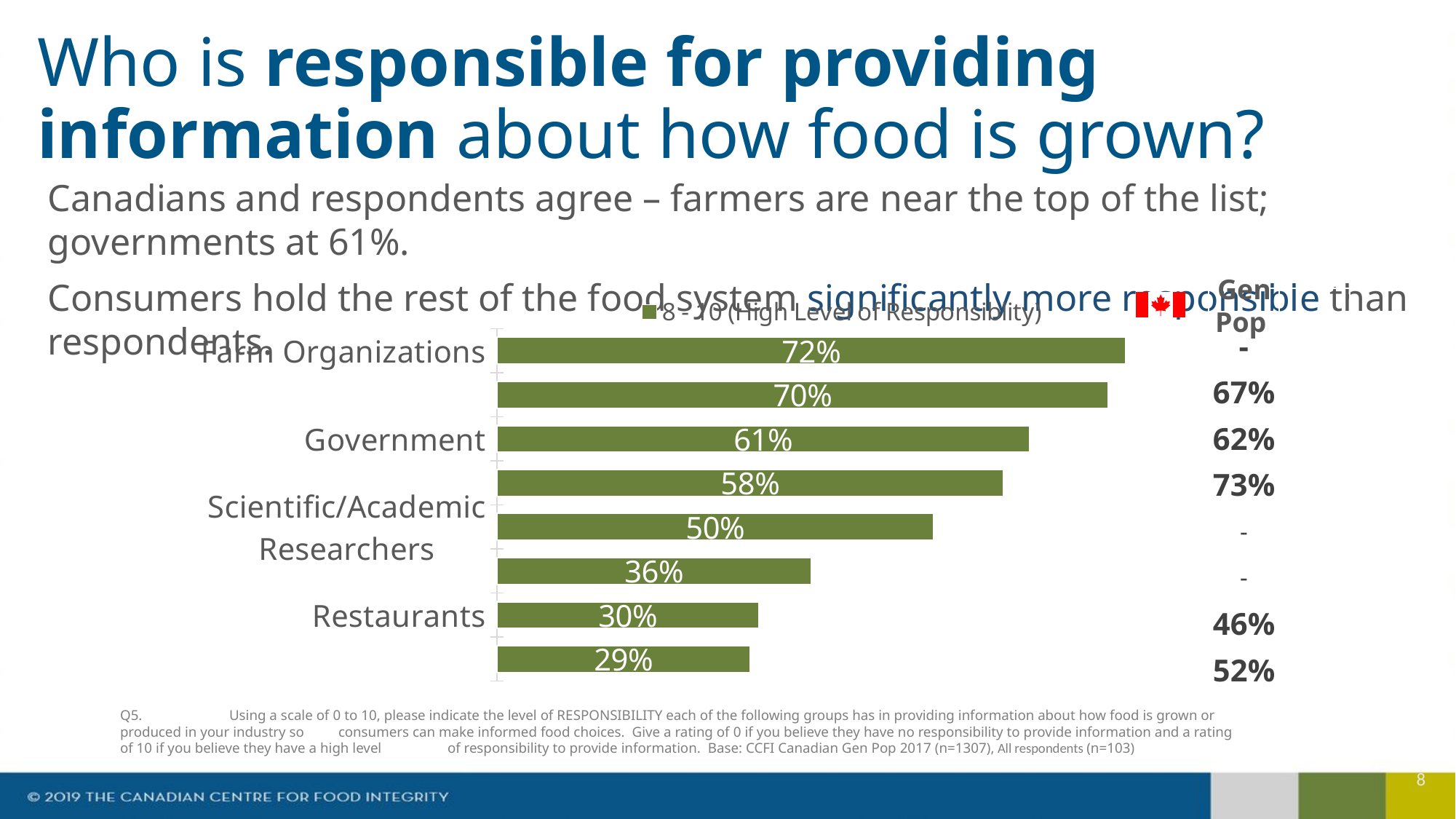
Which labelled category has the highest value in the bar chart? Farm Organizations What is the value shown for Restaurants? 30% How many bars are plotted in the chart? 8 How many series does the chart legend list? 1 What is the difference in percentage points between Farm Organizations and Government? 11 percentage points What type of chart is used on this slide? Bar chart What is the lowest value shown on any bar in the chart? 29% What is the value shown for Scientific/Academic Researchers? 50% What is the Gen Pop value shown next to the Government bar? 62% What is the value shown for Government in the bar chart? 61% Which has a larger value, Government or Restaurants? Government What percentage of respondents gave Farm Organizations a high level of responsibility (8-10)? 72%